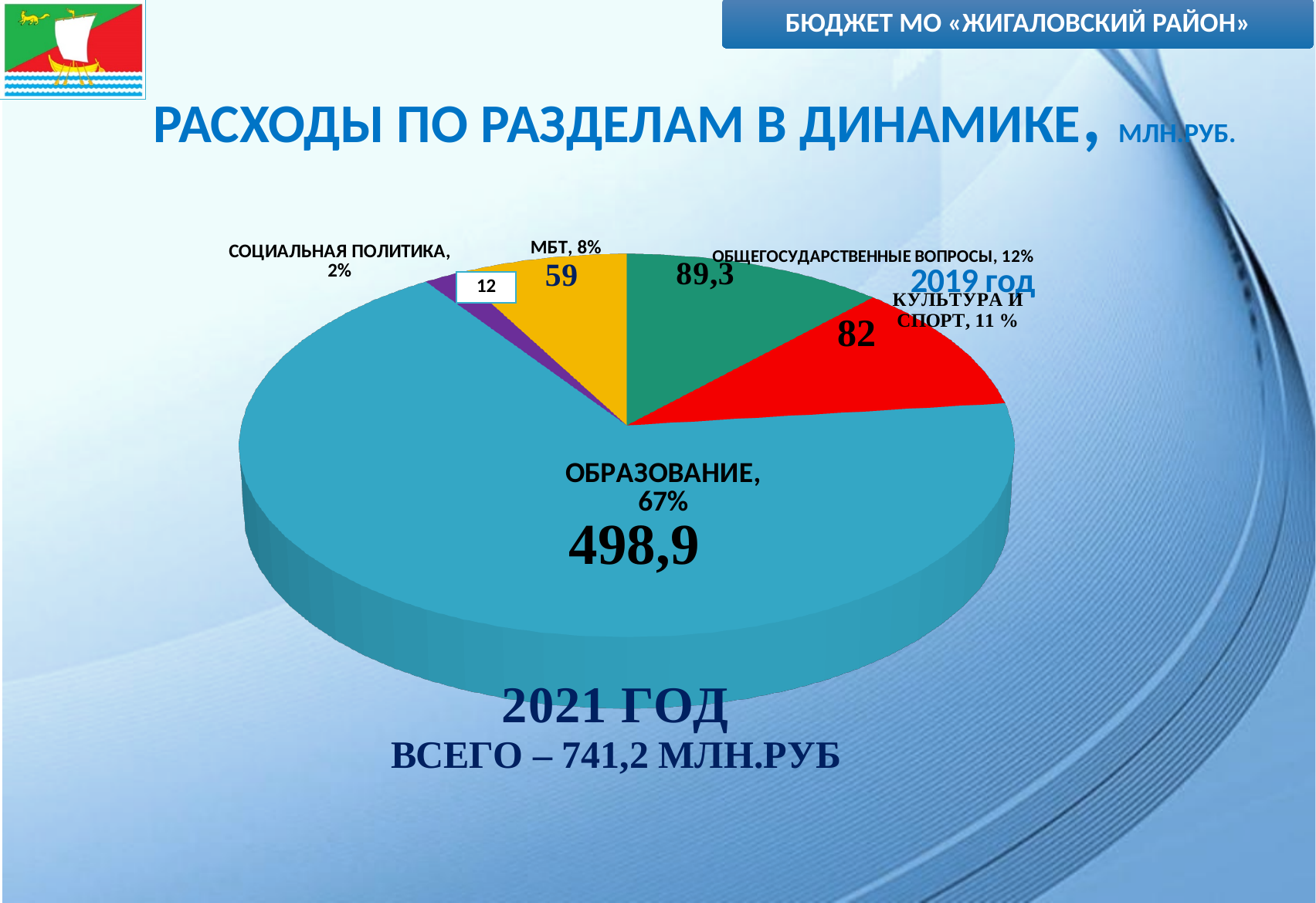
Which is larger, the value for ОБЩЕГОСУДАРСТВЕННЫЕ ВОПРОСЫ or the value for КУЛЬТУРА И СПОРТ? ОБЩЕГОСУДАРСТВЕННЫЕ ВОПРОСЫ What kind of chart is shown on the slide? pie chart What is the value shown for ОБРАЗОВАНИЕ? 498,9 How many slices does the pie chart have? 5 What is the difference between the values for КУЛЬТУРА И СПОРТ and МБТ? 23 What is the value shown for КУЛЬТУРА И СПОРТ? 82 What share of the pie does ОБРАЗОВАНИЕ represent? 67% What is the value shown for МБТ? 59 What is the value shown for СОЦИАЛЬНАЯ ПОЛИТИКА? 12 Which section has the largest share of the pie? ОБРАЗОВАНИЕ Which section has the smallest share of the pie? СОЦИАЛЬНАЯ ПОЛИТИКА What is the value shown for ОБЩЕГОСУДАРСТВЕННЫЕ ВОПРОСЫ? 89,3